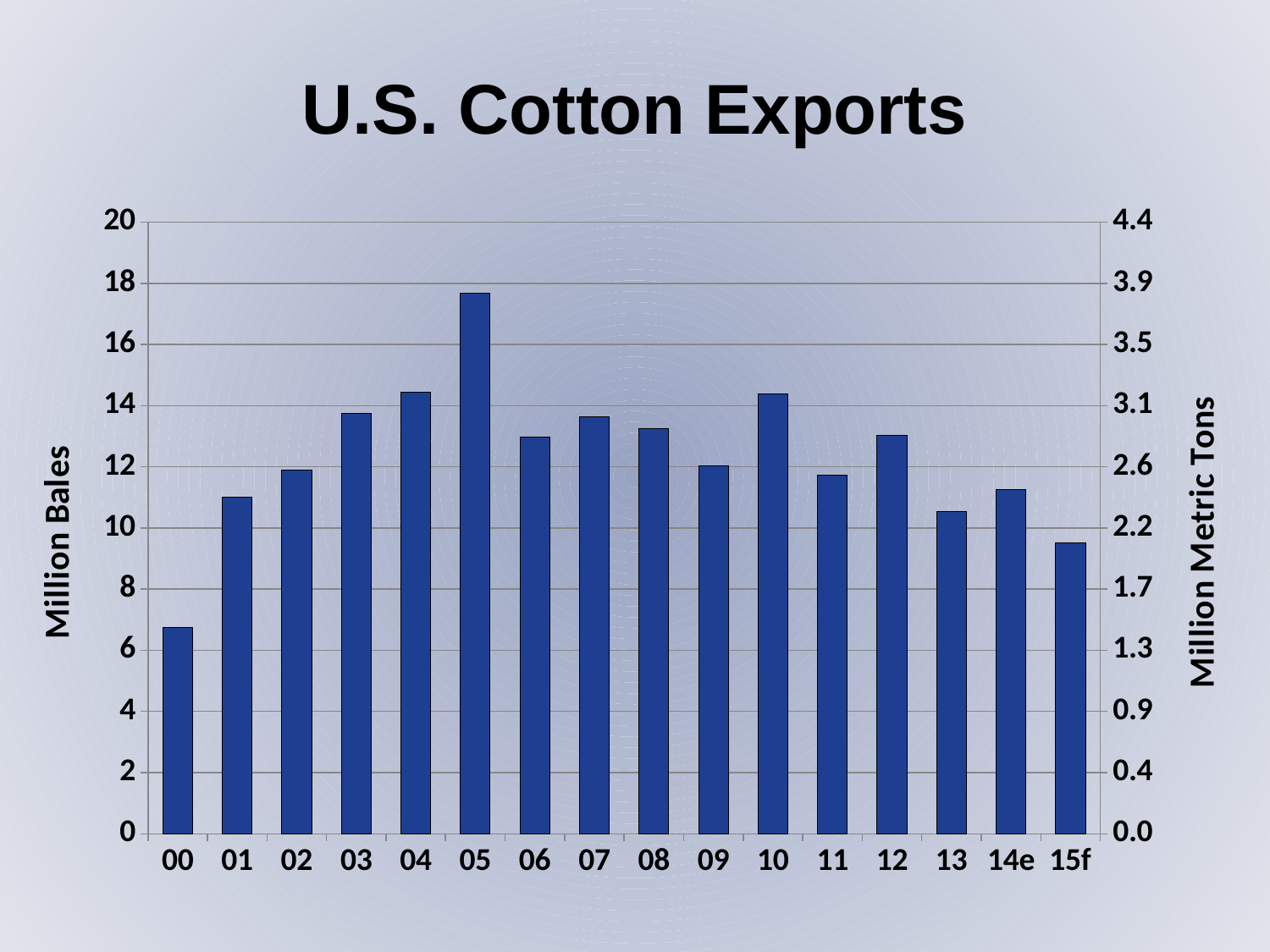
Which year has higher exports, 00 or 15f? 15f Which year has higher exports, 02 or 03? 03 Is the value for 15f greater or less than 10 million bales? less Is the value for 05 greater or less than 16 million bales? greater How many years (categories) are plotted on the x axis? 16 Is the value for 04 greater or less than 12 million bales? greater Do exports generally rise or fall from 00 to 05? rise What kind of chart is shown on the slide? bar chart Which year has the highest U.S. cotton exports? 05 Which year has the lowest U.S. cotton exports? 00 What is the title of the left vertical axis? Million Bales